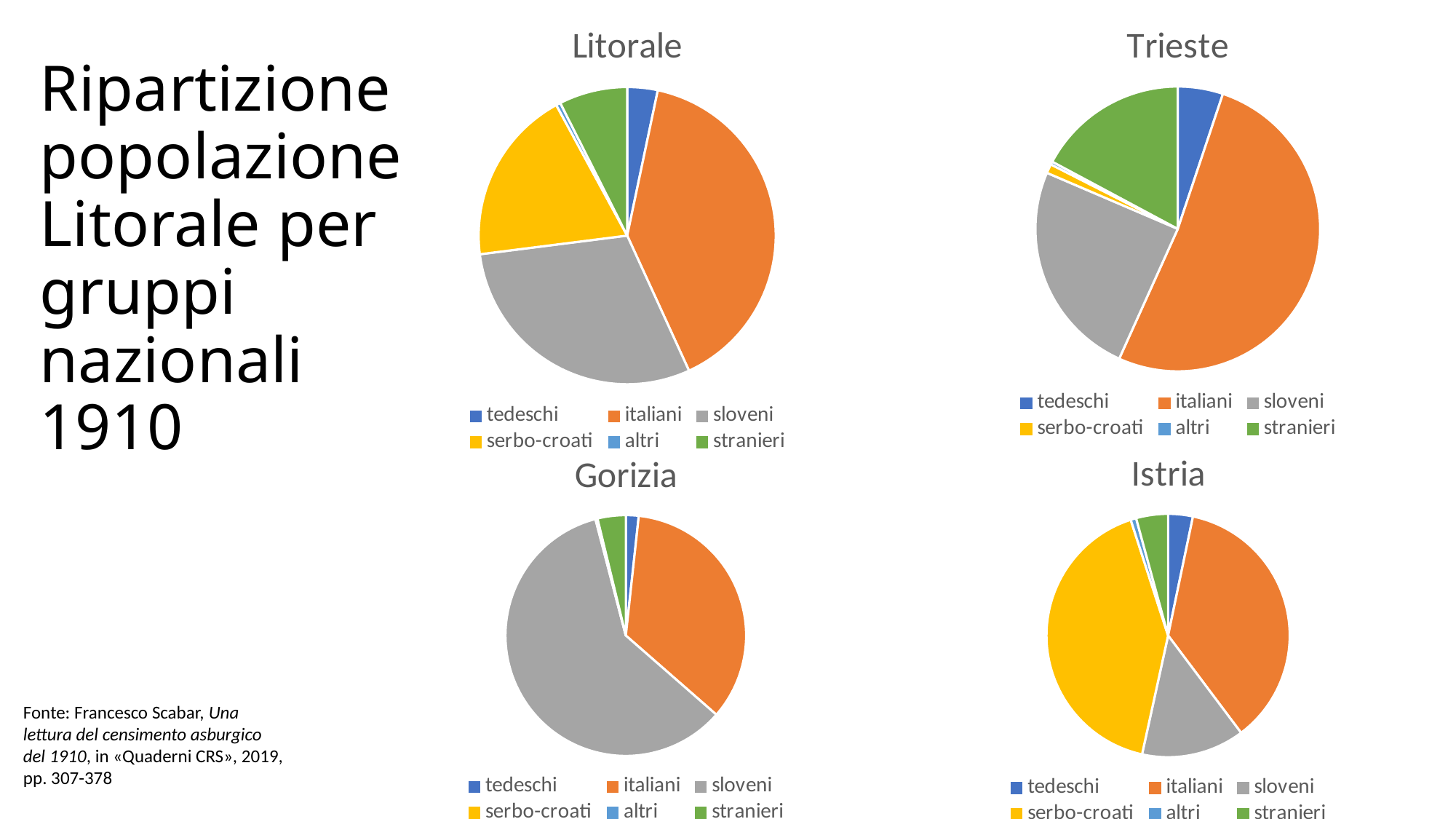
In the Litorale chart, which group has the smallest slice? altri In the Litorale chart, which group has the largest slice? italiani Which colour represents the sloveni group in the charts? grey In the Istria chart, which slice is larger, italiani or sloveni? italiani In the Gorizia chart, which group has the largest slice? sloveni How many pie charts are shown on the slide? 4 How many groups does the legend of the Trieste chart list? 6 In the Litorale chart, which slice is larger, serbo-croati or tedeschi? serbo-croati In the Trieste chart, which slice is larger, stranieri or serbo-croati? stranieri What kind of chart is used for the Litorale chart? pie chart In the Trieste chart, which group has the largest slice? italiani